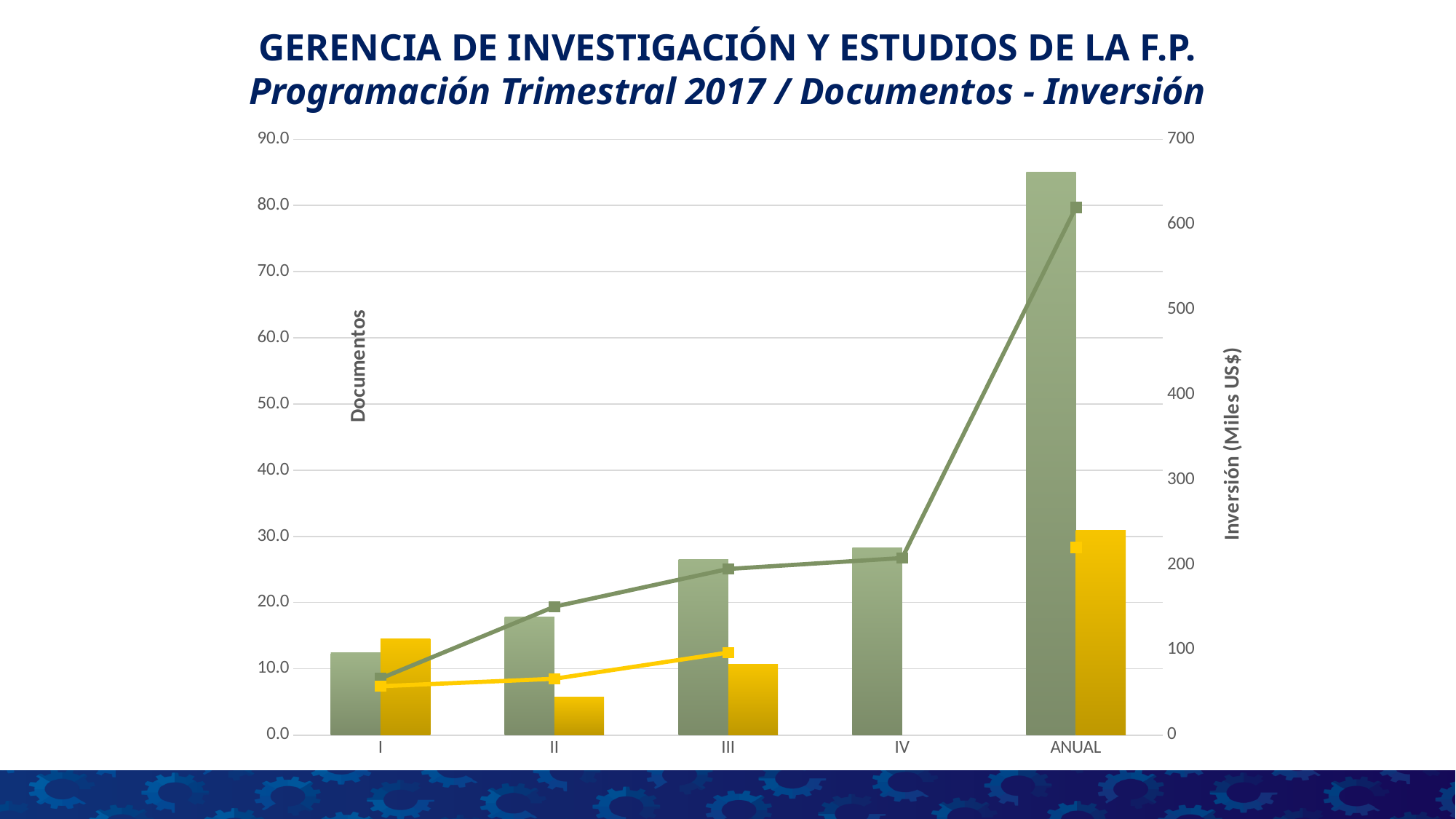
Which category has the tallest green bar? ANUAL Which is taller for category II, the green bar or the yellow bar? The green bar What kind of chart is shown on the slide? Combination bar and line chart Which category has the tallest yellow bar? ANUAL Is the yellow bar for ANUAL greater or less than 20.0 on the left axis? greater Which category has the shortest green bar? I Do the green bars rise or fall from I to ANUAL along the x axis? Rise How many categories are shown on the x axis? 5 Is the green line point for ANUAL greater or less than 500 on the right axis? greater Is the green bar for ANUAL greater or less than 80.0 on the left axis? greater What is the title of the right-hand vertical axis? Inversión (Miles US$)